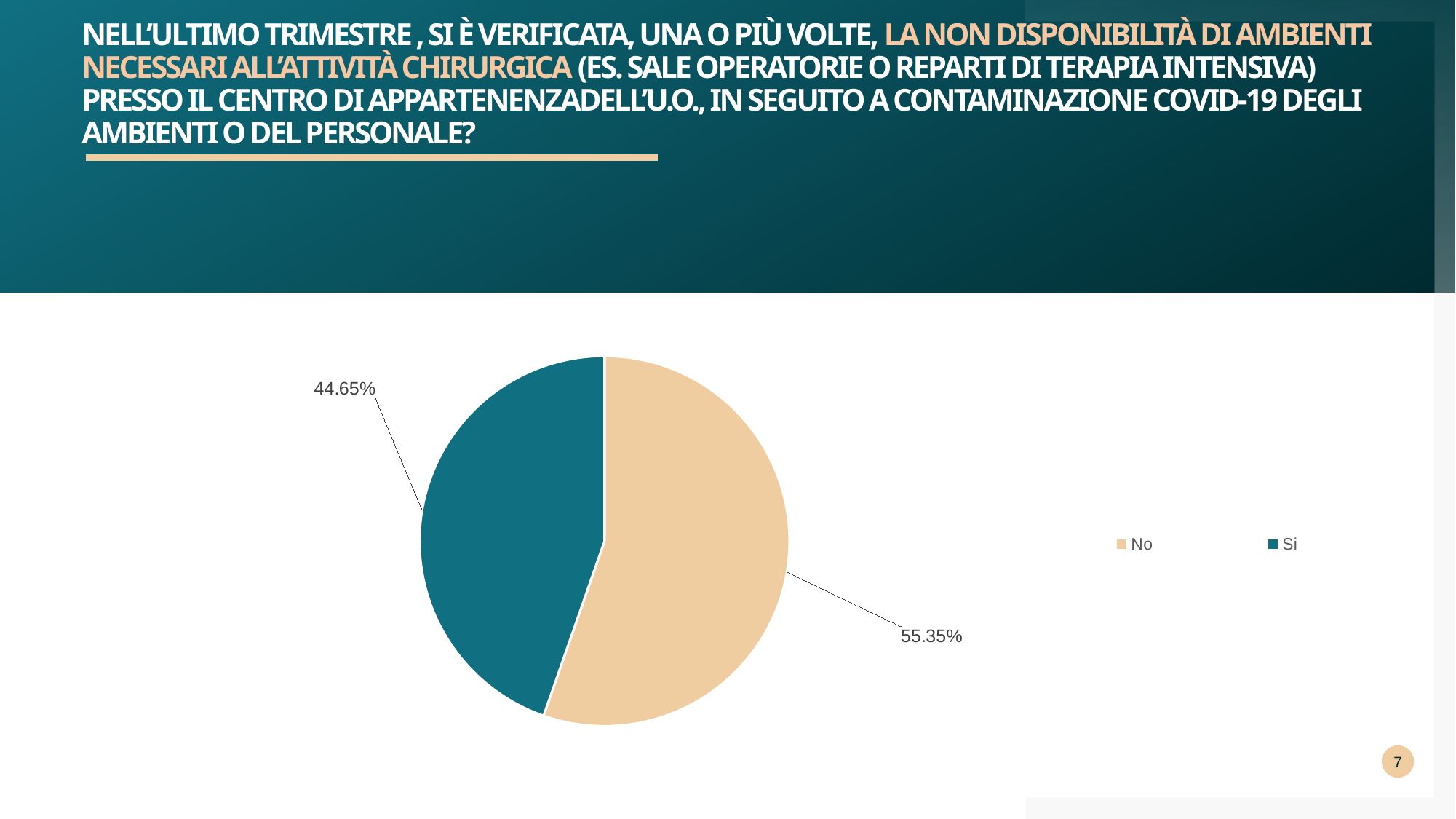
What share of the pie does the "Si" slice represent? 44.65% What colour is the "No" slice in the pie chart? beige Which slice is the largest in the pie chart? No Which slice is the smallest in the pie chart? Si What share of the pie does the "No" slice represent? 55.35% What is the difference in percentage points between the "No" slice and the "Si" slice? 10.70 What kind of chart is shown on the slide? pie chart Which is larger, the "No" slice or the "Si" slice? No What colour is the "Si" slice in the pie chart? teal How many slices does the pie chart have? 2 How many entries does the legend list? 2